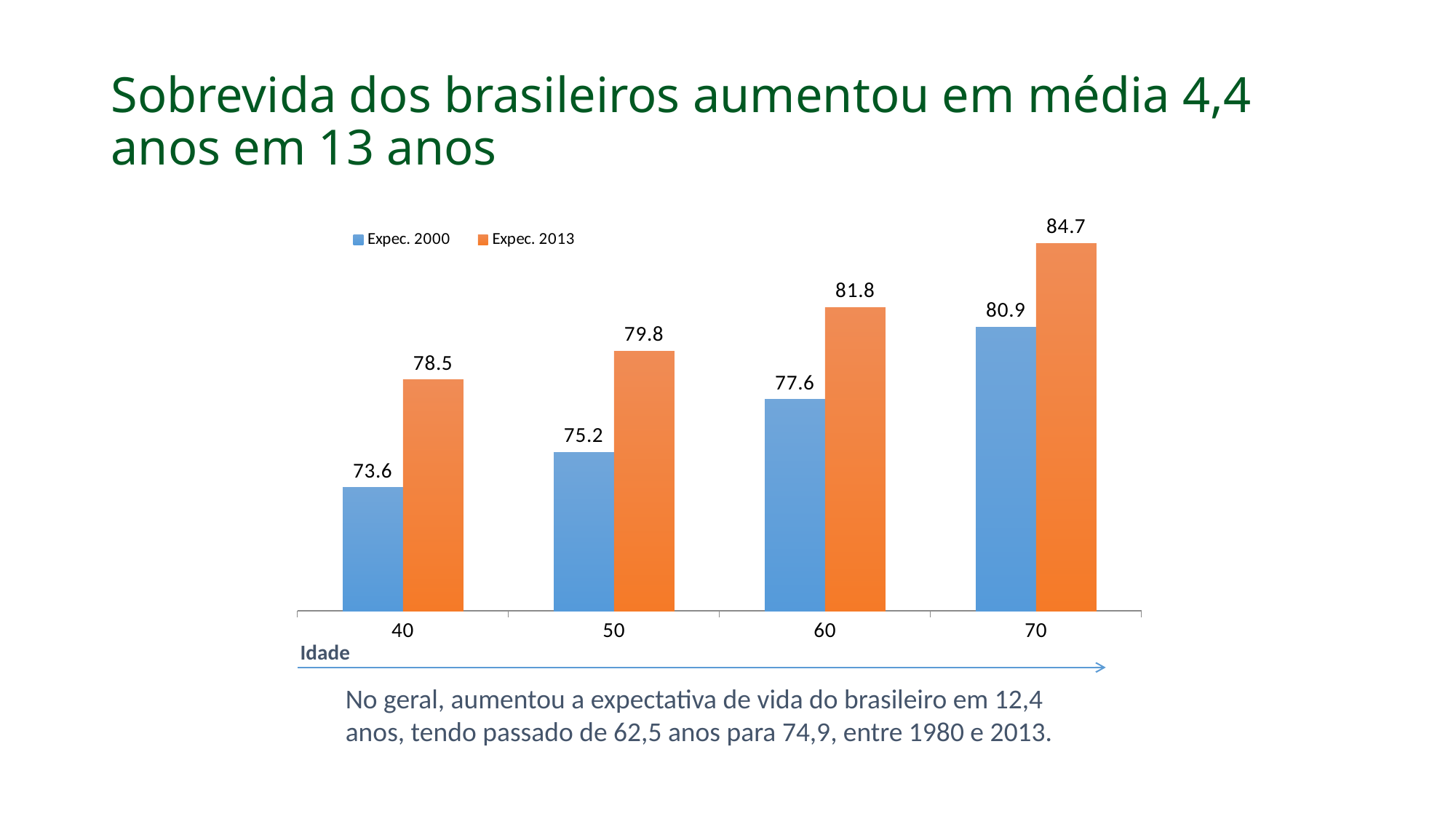
Which age group has the lowest Expec. 2000 value? 40 Do the Expec. 2000 values rise or fall as age increases along the x axis? Rise What is the Expec. 2013 value for age 70? 84.7 What is the difference between the Expec. 2013 and Expec. 2000 values for age 40? 4.9 What is the difference between the Expec. 2013 and Expec. 2000 values for age 50? 4.6 What is the Expec. 2013 value for age 60? 81.8 What kind of chart is shown on the slide? Bar chart Which is larger for age 60: the Expec. 2000 value or the Expec. 2013 value? Expec. 2013 How many series does the legend list? 2 How many age categories are shown on the x axis? 4 Which age group has the highest Expec. 2013 value? 70 What is the Expec. 2000 value for age 40? 73.6